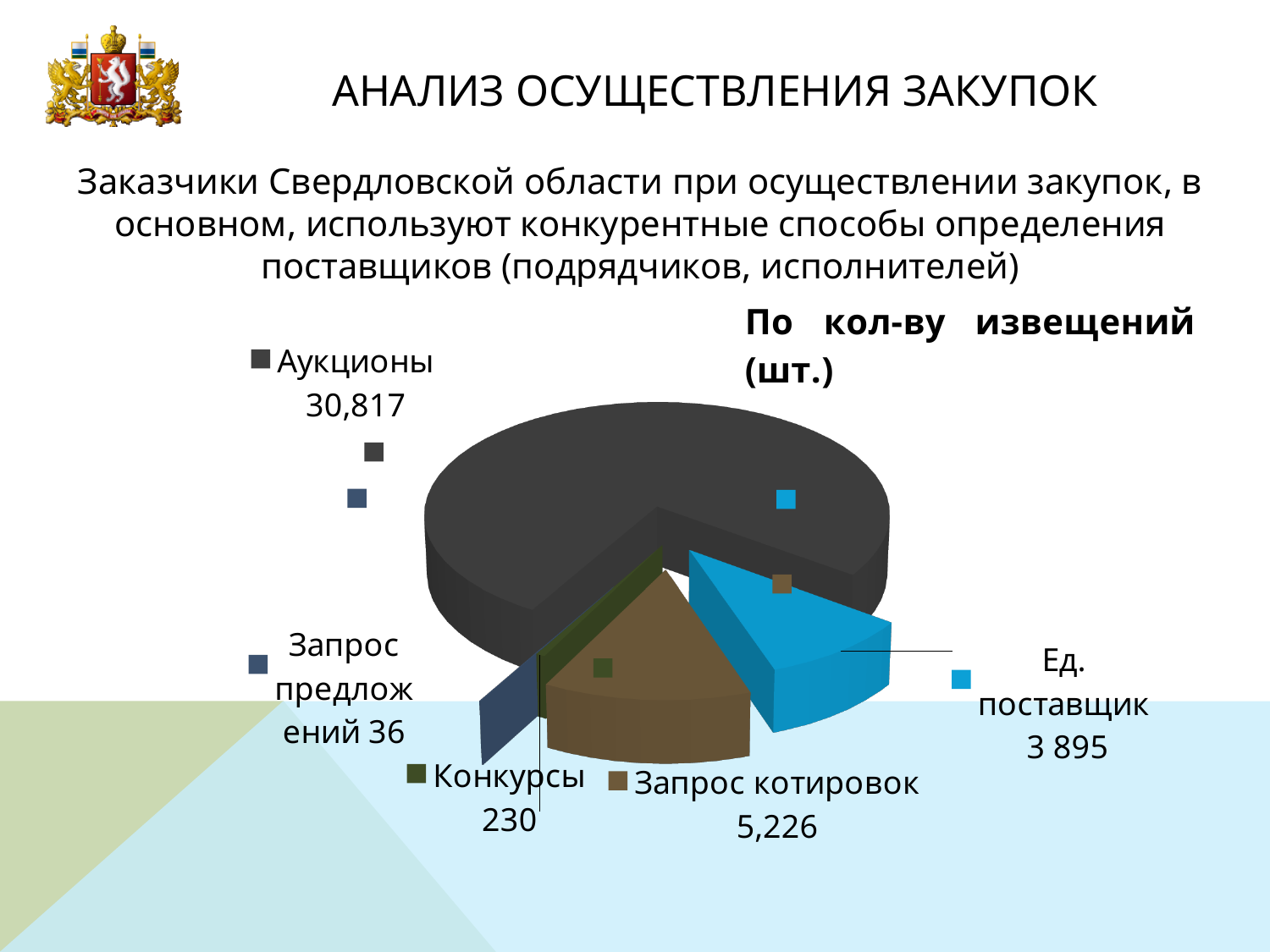
Which category has the lowest value? Запрос предложений Which is larger, Запрос котировок or Ед. поставщик? Запрос котировок What is the value for Запрос предложений? 36 What is the title of the chart? По кол-ву извещений (шт.) What is the difference between the values for Аукционы and Запрос котировок? 25,591 How many categories does the pie chart show? 5 What is the value for Ед. поставщик? 3 895 What kind of chart is shown on the slide? Pie chart What is the value for Запрос котировок? 5,226 What is the value for Аукционы? 30,817 Which category has the highest value? Аукционы What is the value for Конкурсы? 230